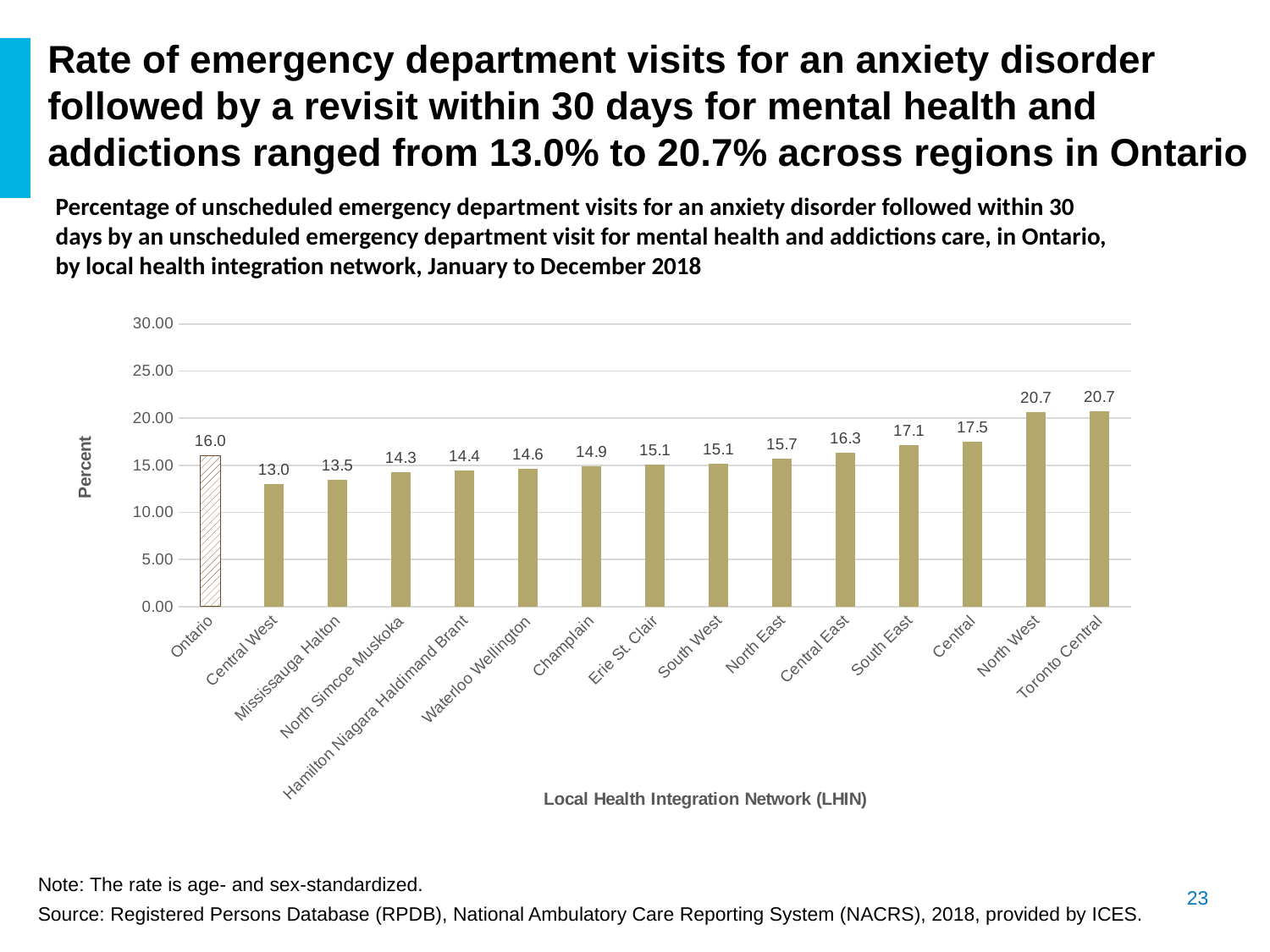
What is the difference between the values for Central East and Ontario? 0.3 How many bars are plotted in the chart? 15 Which two LHINs share the highest value of 20.7? North West and Toronto Central What is the value for Toronto Central? 20.7 Which is larger, the value for South East or the value for North East? South East What is the value for Hamilton Niagara Haldimand Brant? 14.4 What kind of chart is shown on the slide? Bar chart What is the label of the y axis? Percent What is the value for Central West? 13.0 What is the value for Ontario? 16.0 What is the difference between the values for Toronto Central and Central West? 7.7 Which LHIN has the lowest value? Central West